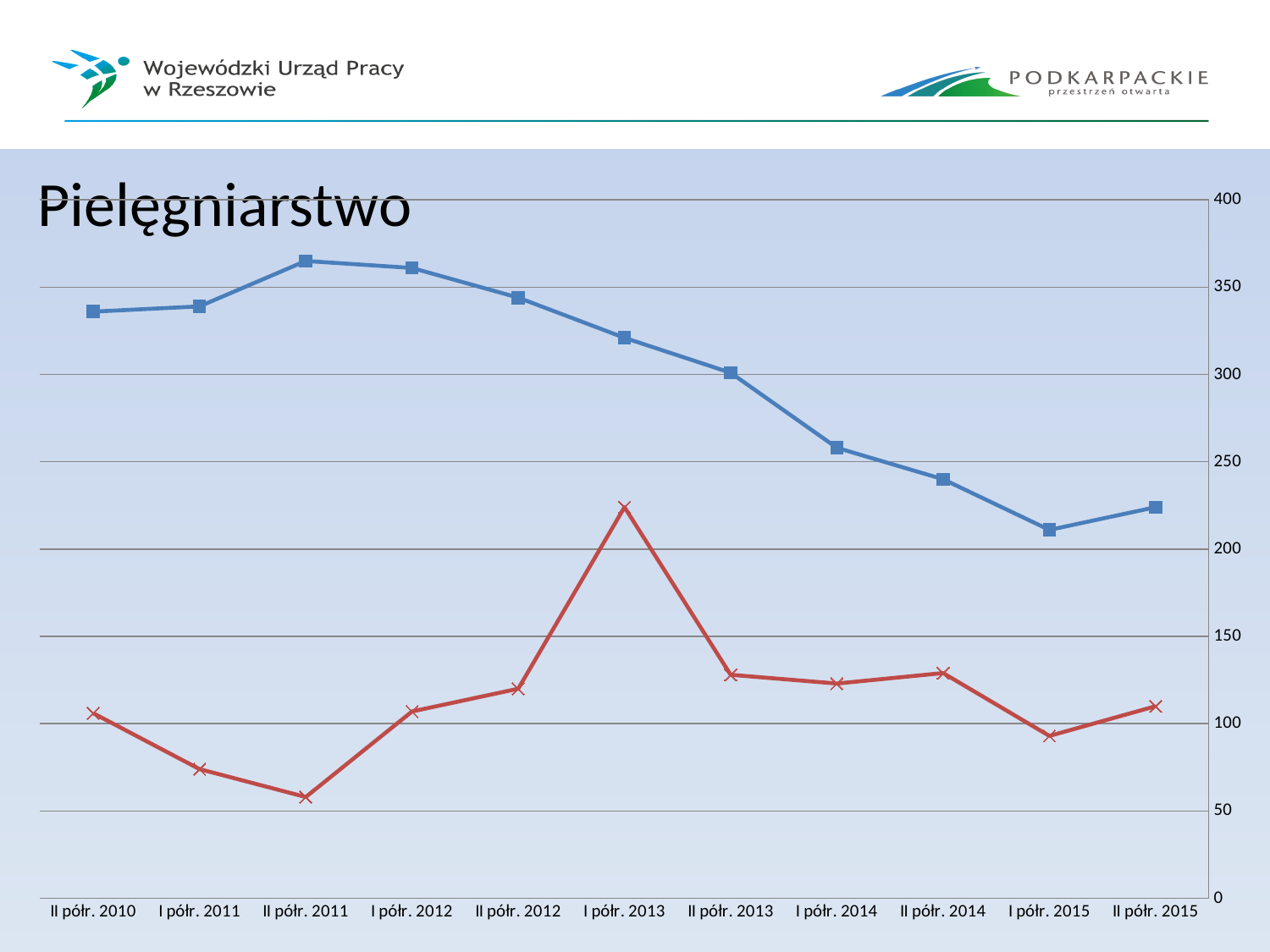
In which period does the red line with x markers reach its lowest value? II półr. 2011 In which period does the blue line with square markers reach its lowest value? I półr. 2015 What is the title of the chart? Pielęgniarstwo Is the value of the red line with x markers for I półr. 2013 greater or less than 200? greater Is the value of the red line with x markers for II półr. 2011 greater or less than 100? less Does the blue line with square markers rise or fall between II półr. 2011 and I półr. 2015? fall How many lines are plotted on the chart? 2 Is the value of the blue line with square markers for II półr. 2010 greater or less than 300? greater How many time periods are shown on the x axis of the chart? 11 What kind of chart is shown on the slide? line chart In which period does the red line with x markers reach its highest value? I półr. 2013 For I półr. 2013, which line has the higher value, the blue line with square markers or the red line with x markers? the blue line with square markers